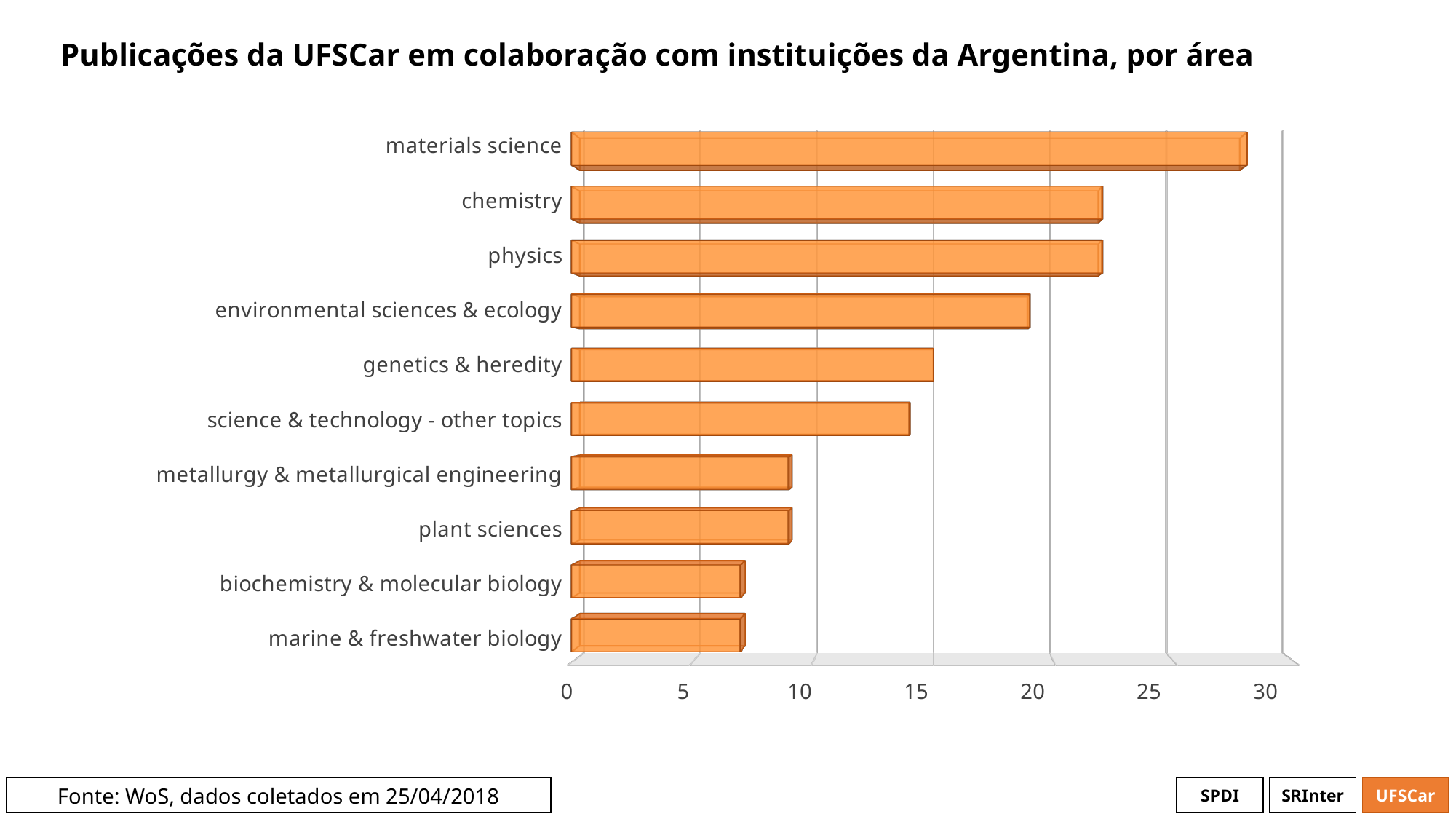
Which has more publications, environmental sciences & ecology or genetics & heredity? environmental sciences & ecology Is the value for marine & freshwater biology greater or less than 5? greater How many areas (categories) are shown in the chart? 10 Which area has the highest number of publications? materials science Is the value for biochemistry & molecular biology greater or less than 10? less Which has more publications, materials science or chemistry? materials science Is the value for genetics & heredity greater or less than 20? less What is the title of the chart? Publicações da UFSCar em colaboração com instituições da Argentina, por área What kind of chart is shown on the slide? bar chart